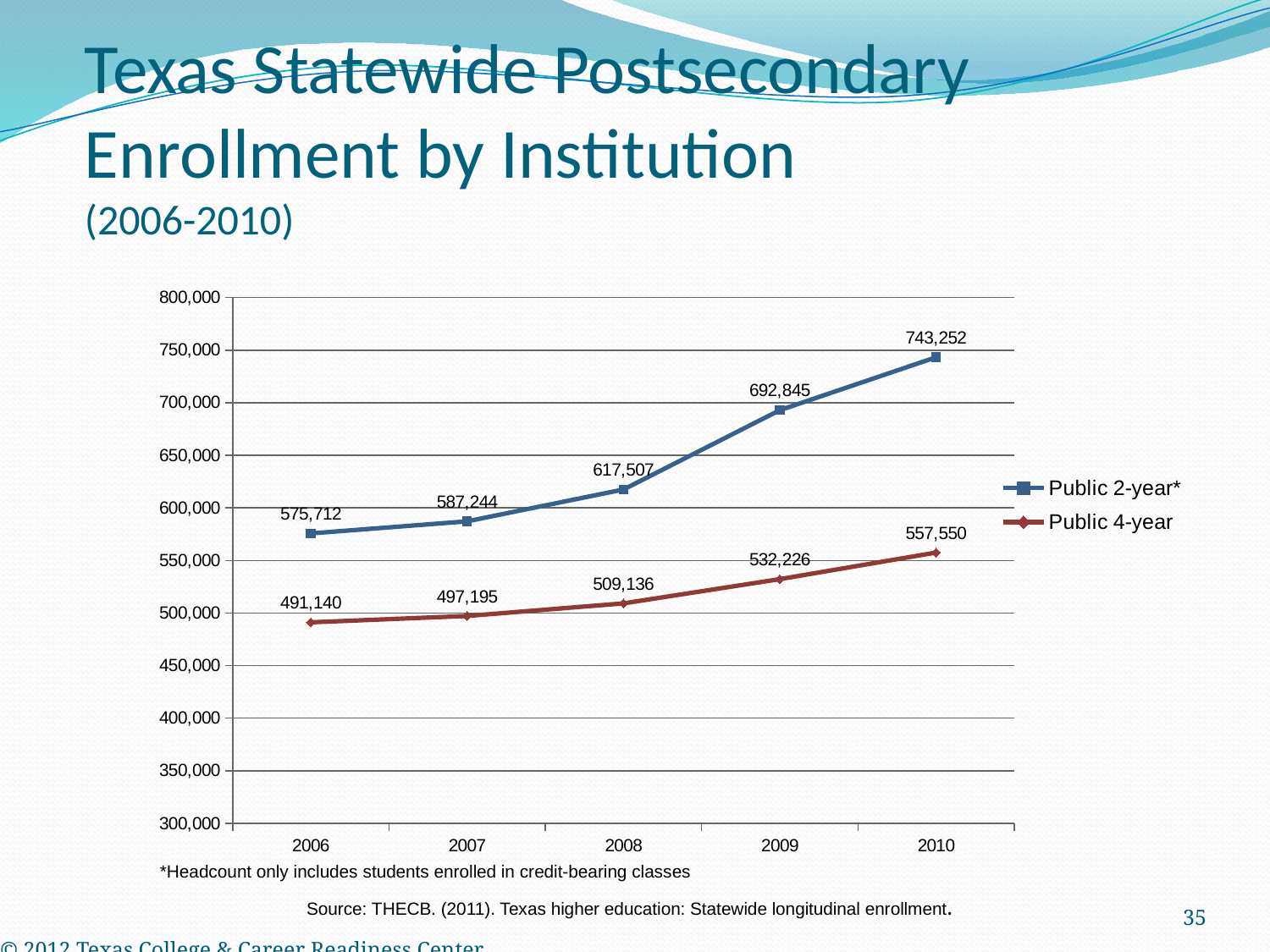
What was the Public 4-year enrollment in 2006? 491,140 What was the Public 2-year* enrollment in 2010? 743,252 In which year was Public 2-year* enrollment lowest? 2006 Which was larger in 2009: Public 2-year* or Public 4-year enrollment? Public 2-year* What is the difference between Public 2-year* and Public 4-year enrollment in 2010? 185,702 How many years are shown on the x axis? 5 In which year was Public 4-year enrollment highest? 2010 Is the Public 2-year* enrollment in 2009 greater or less than 700,000? less What kind of chart is shown on the slide? line chart What was the Public 4-year enrollment in 2008? 509,136 By how much did Public 2-year* enrollment increase from 2008 to 2009? 75,338 How many series does the legend list? 2